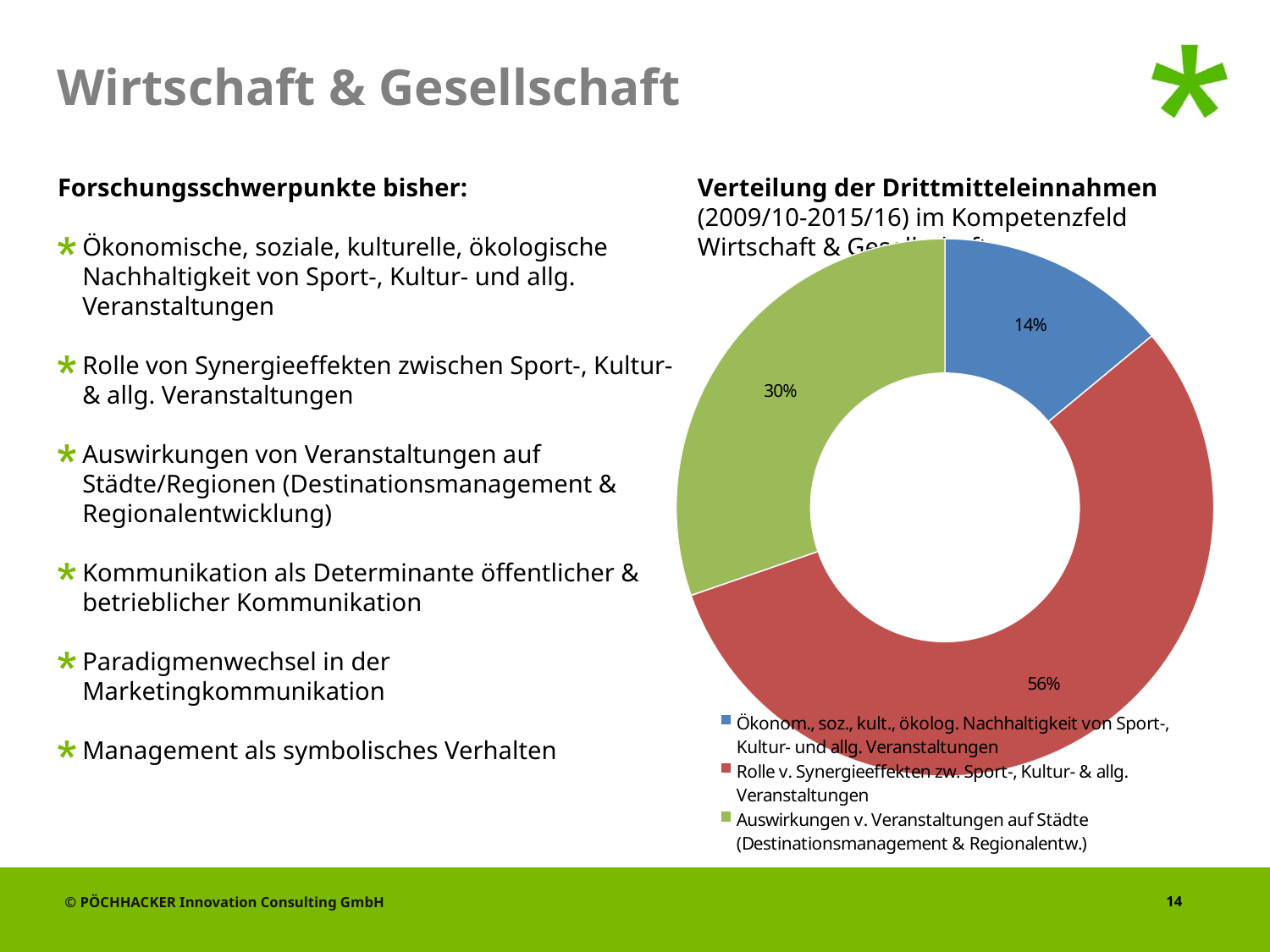
What share of the third-party funding income is attributed to "Rolle v. Synergieeffekten zw. Sport-, Kultur- & allg. Veranstaltungen"? 56% How many percentage points larger is the share for "Rolle v. Synergieeffekten" than the share for "Auswirkungen v. Veranstaltungen auf Städte"? 26 percentage points How many categories does the doughnut chart show? 3 Which category has the smallest share of the third-party funding income? Ökonom., soz., kult., ökolog. Nachhaltigkeit von Sport-, Kultur- und allg. Veranstaltungen Which is larger: the share for "Auswirkungen v. Veranstaltungen auf Städte" or the share for "Ökonom., soz., kult., ökolog. Nachhaltigkeit"? Auswirkungen v. Veranstaltungen auf Städte What share of the third-party funding income is attributed to "Auswirkungen v. Veranstaltungen auf Städte (Destinationsmanagement & Regionalentw.)"? 30% What is the title of the chart? Verteilung der Drittmitteleinnahmen (2009/10-2015/16) im Kompetenzfeld Wirtschaft & Gesellschaft What type of chart is shown on the slide? Doughnut (pie) chart How many entries does the chart legend list? 3 Which category has the largest share of the third-party funding income? Rolle v. Synergieeffekten zw. Sport-, Kultur- & allg. Veranstaltungen What share of the third-party funding income is attributed to "Ökonom., soz., kult., ökolog. Nachhaltigkeit von Sport-, Kultur- und allg. Veranstaltungen"? 14% What colour is the slice representing "Rolle v. Synergieeffekten zw. Sport-, Kultur- & allg. Veranstaltungen"? Red